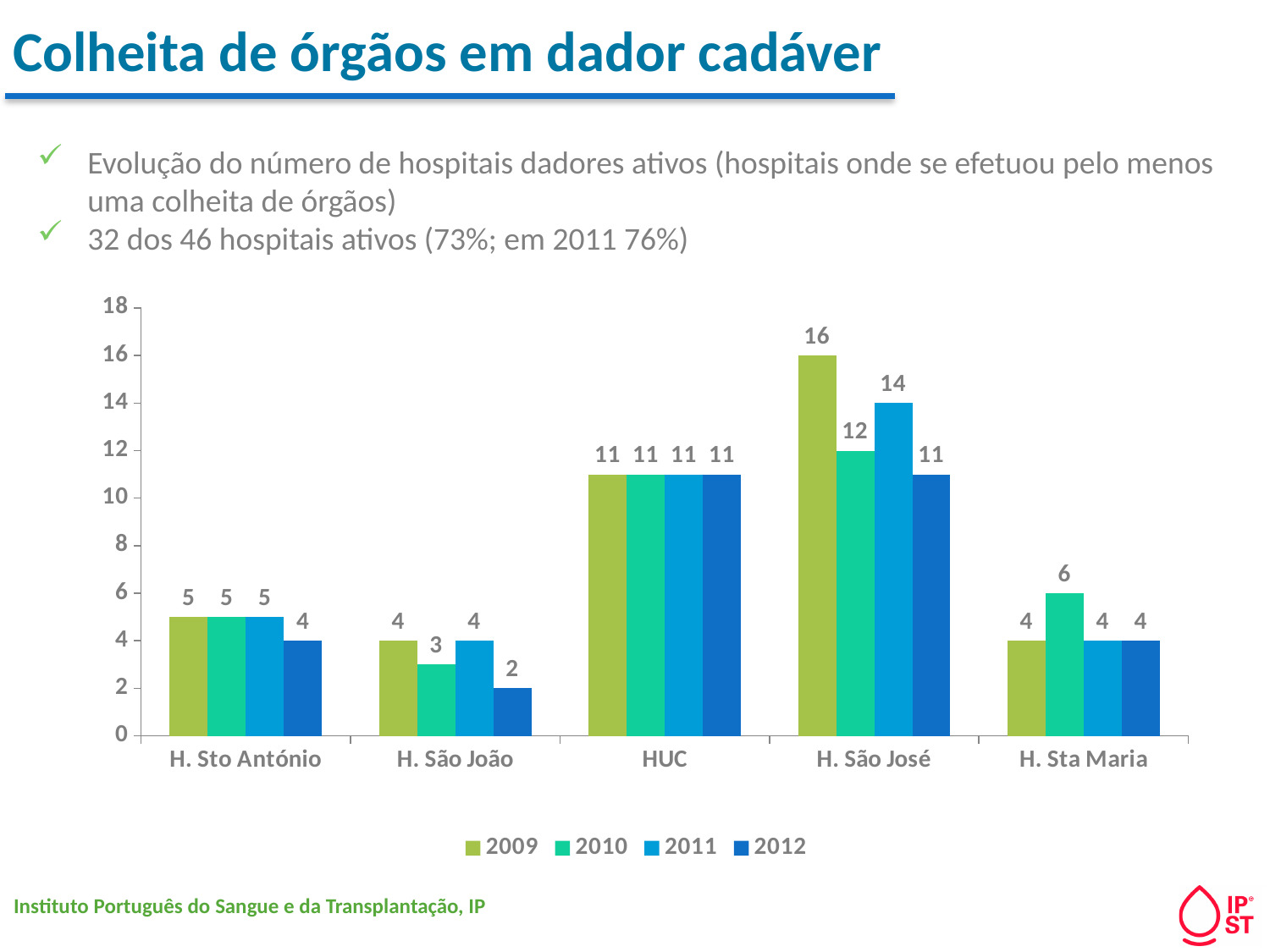
What kind of chart is shown on the slide? bar chart What is the value for H. São João in 2012? 2 What is the value for H. Sta Maria in 2010? 6 How many series does the legend list? 4 Which years are listed in the legend? 2009, 2010, 2011, 2012 Which is larger: the 2010 value for H. São José or the 2011 value for H. São José? 2011 Which hospital has the highest value in 2011? H. São José Do the values for H. São José rise or fall from 2011 to 2012? fall What is the difference between the 2009 and 2012 values for H. São José? 5 How many hospitals are shown on the x axis? 5 What is the value for H. São José in 2009? 16 Which hospital has the lowest value in 2012? H. São João